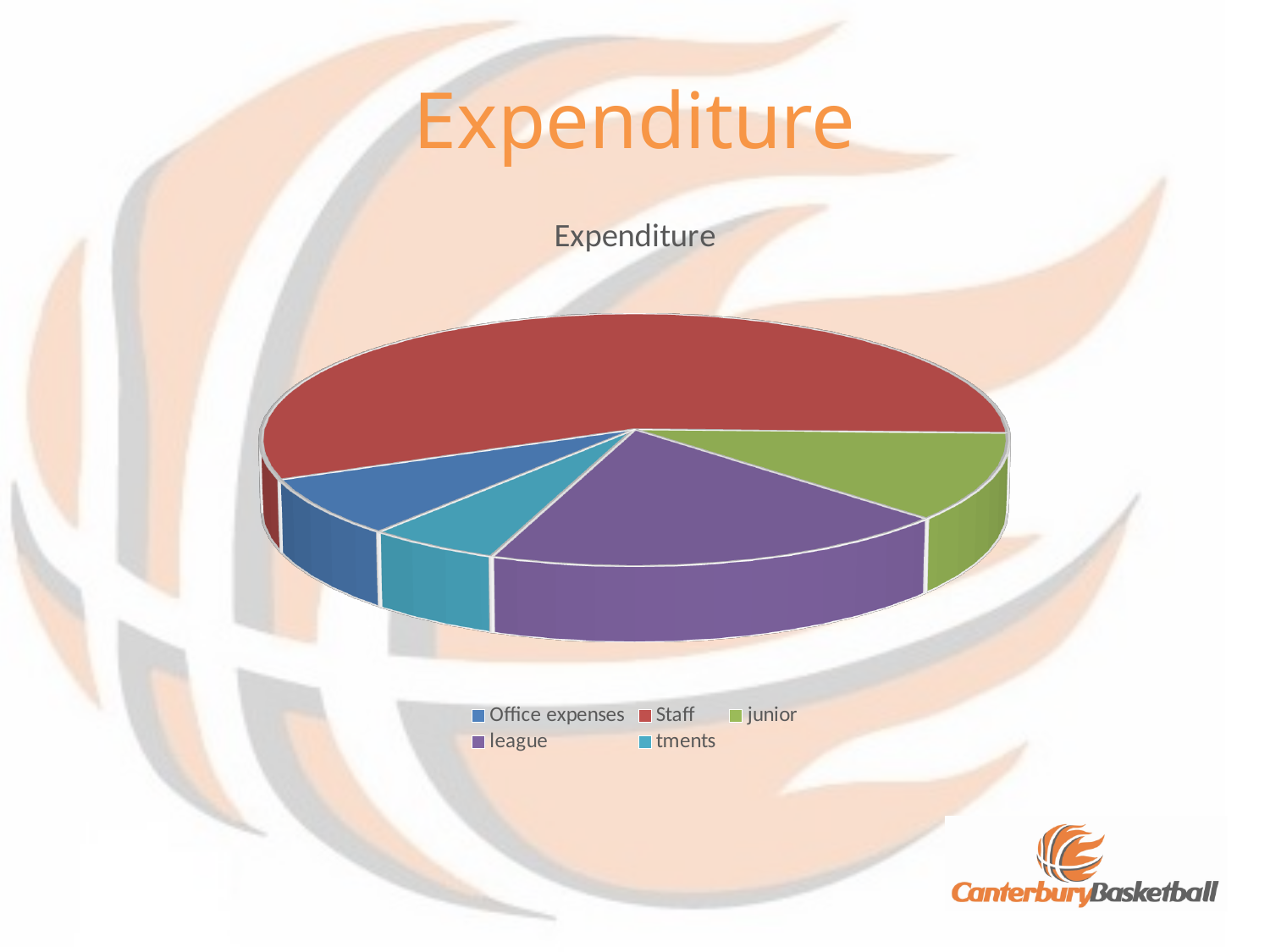
Which slice is larger, league or junior? league Which slice is larger, Staff or junior? Staff What is the title of the chart? Expenditure How many categories does the pie chart have? 5 What kind of chart is shown on the slide? Pie chart Which slice is larger, league or Office expenses? league Which category is shown in red in the pie chart? Staff Which category has the second-largest slice of the pie? league Which category has the largest slice of the pie? Staff